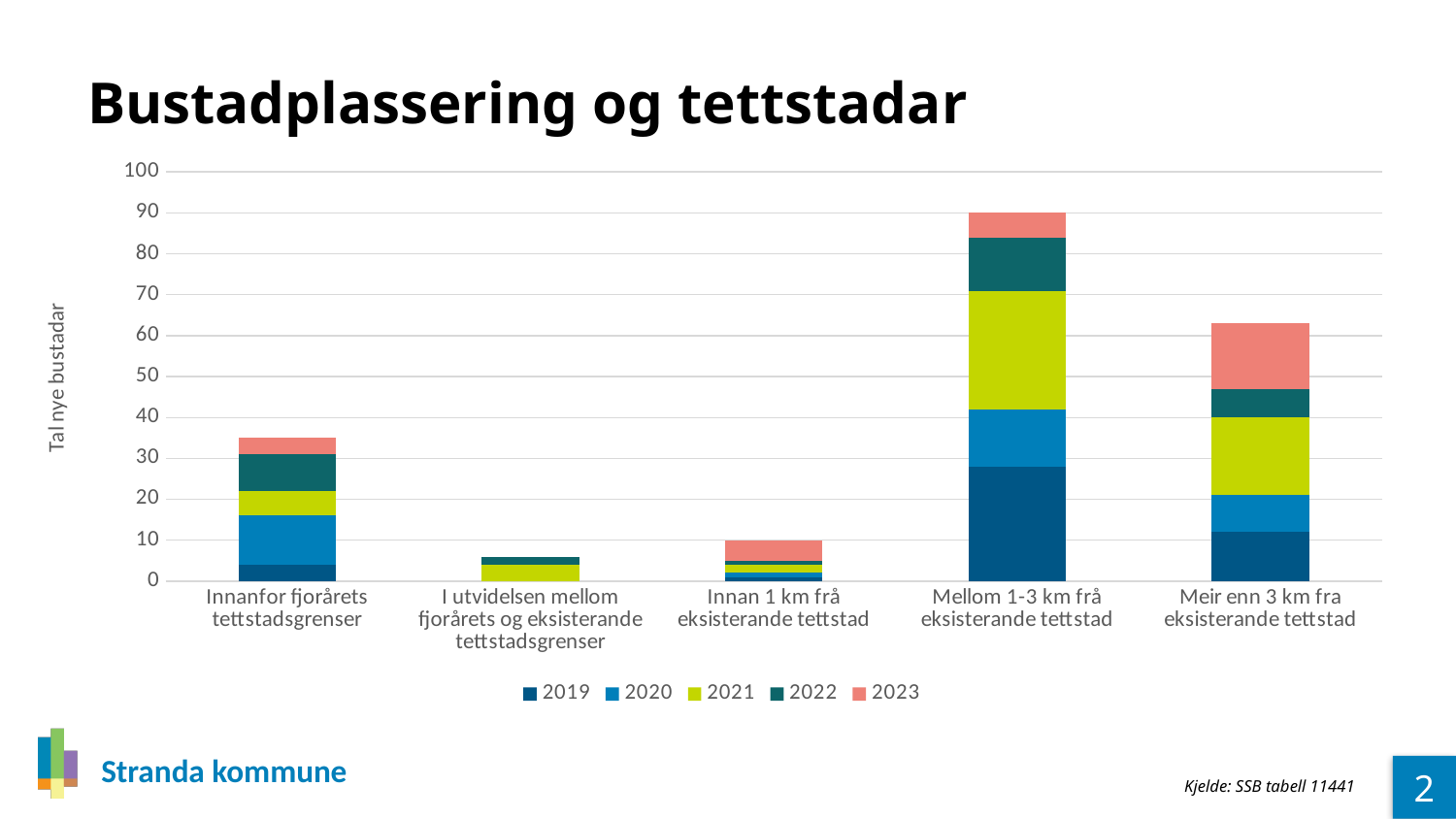
Is the total stacked bar for 'Mellom 1-3 km frå eksisterande tettstad' greater or less than 80? greater Is the total stacked bar for 'Meir enn 3 km fra eksisterande tettstad' greater or less than 50? greater What is the label on the y axis? Tal nye bustadar Is the total stacked bar for 'Innanfor fjorårets tettstadsgrenser' greater or less than 40? less What is the title of the slide? Bustadplassering og tettstadar How many series does the legend list? 5 Which category has the shortest stacked bar? I utvidelsen mellom fjorårets og eksisterande tettstadsgrenser Which has a taller stacked bar: 'Innanfor fjorårets tettstadsgrenser' or 'Innan 1 km frå eksisterande tettstad'? Innanfor fjorårets tettstadsgrenser Which has a taller stacked bar: 'Meir enn 3 km fra eksisterande tettstad' or 'Mellom 1-3 km frå eksisterande tettstad'? Mellom 1-3 km frå eksisterande tettstad How many categories are shown along the x axis? 5 What kind of chart is shown on the slide? stacked bar chart Which category has the tallest stacked bar? Mellom 1-3 km frå eksisterande tettstad